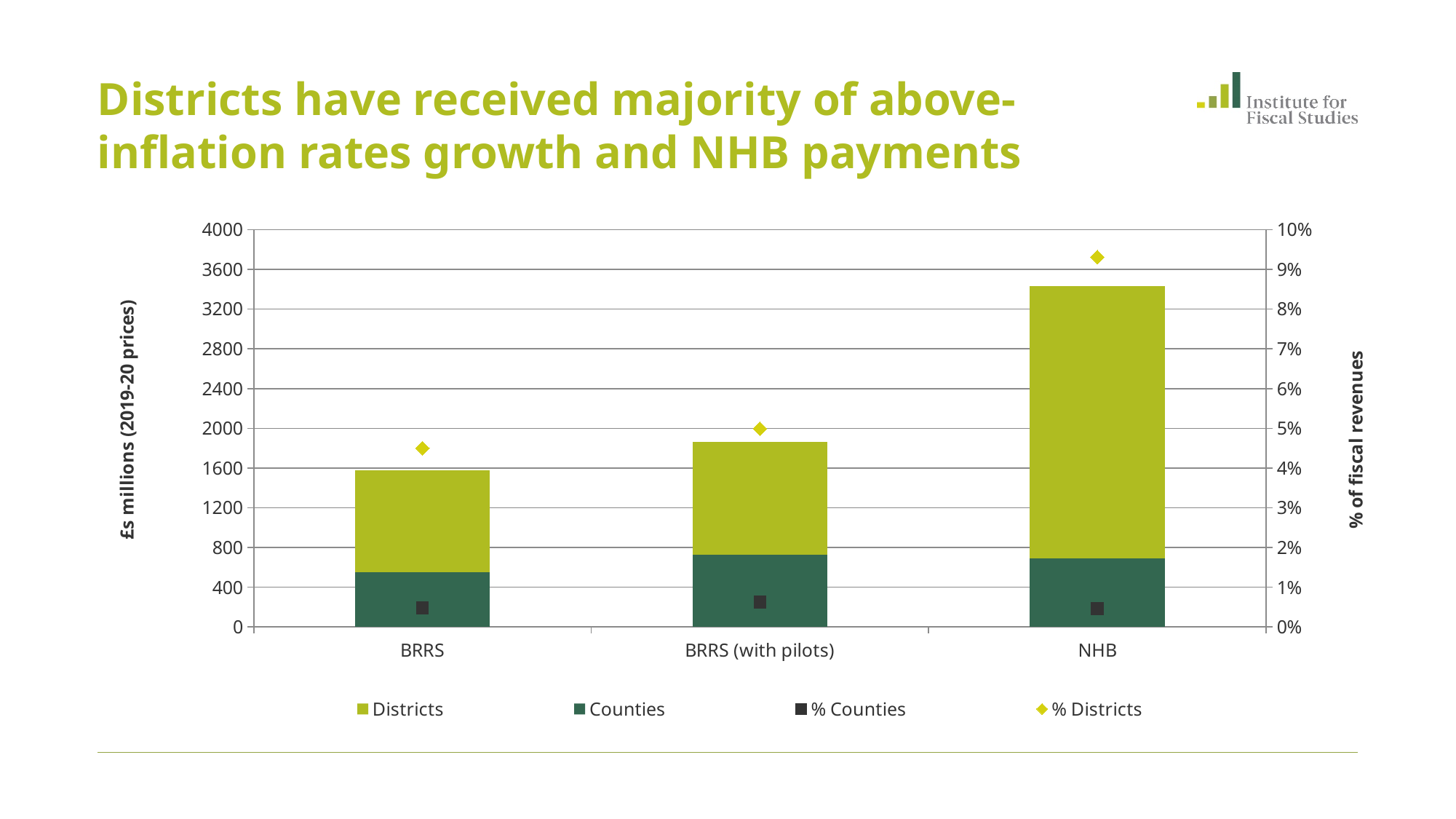
Is the total bar for NHB greater or less than 3200? greater Which category has the highest total bar? NHB Is the % Districts value for BRRS greater or less than 5%? less What is the title of the left vertical axis? £s millions (2019-20 prices) Is the % Districts value for NHB greater or less than 8%? greater Which is larger, the Districts segment for NHB or the Districts segment for BRRS? NHB How many categories are shown along the x axis? 3 Which category has the lowest total bar? BRRS Do the total bar heights rise or fall moving from BRRS to NHB along the x axis? rise How many series does the legend list? 4 What kind of chart is shown on the slide? bar chart